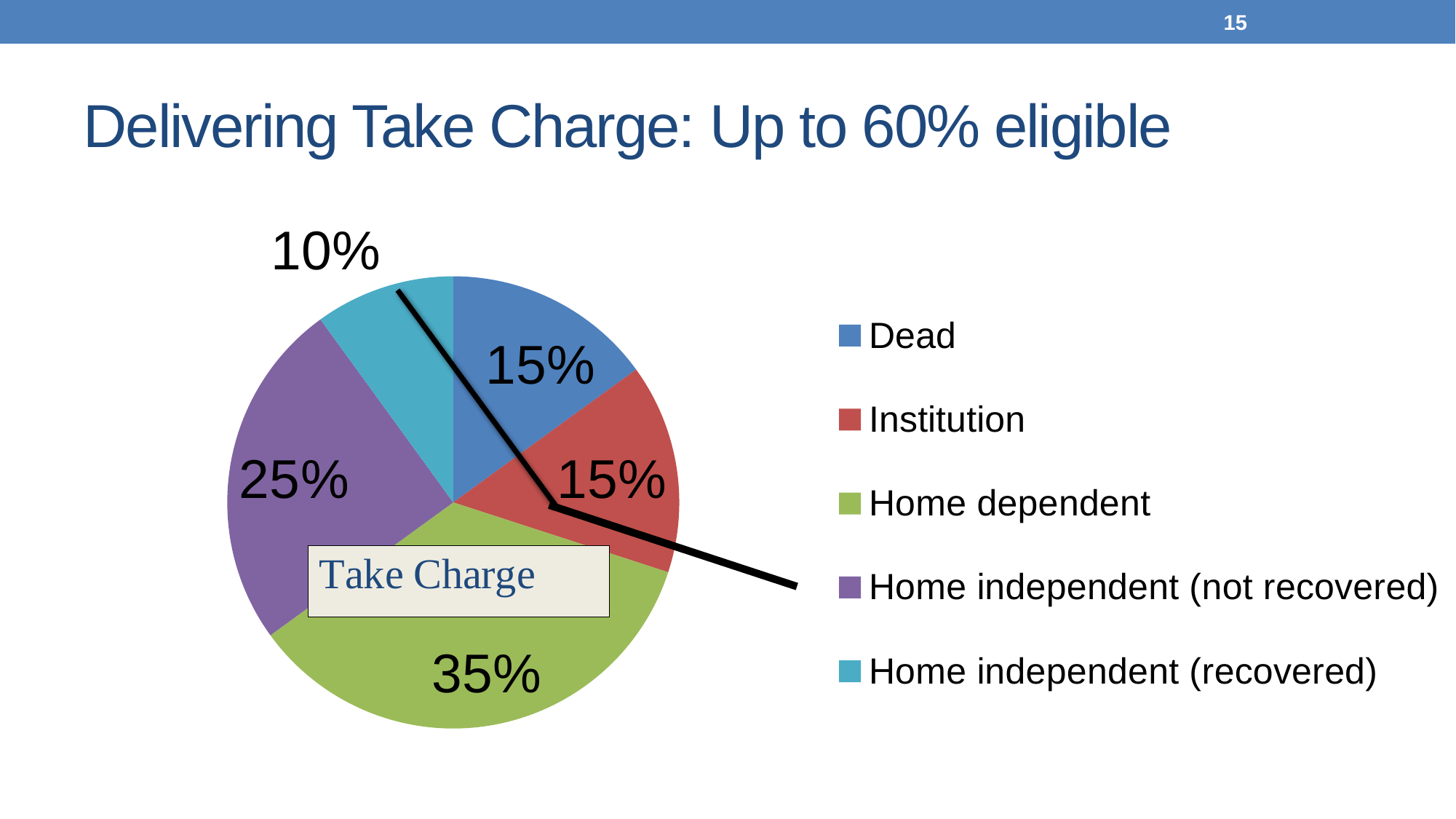
What percentage of the pie is labelled Home independent (recovered)? 10% Which is larger, the Home independent (not recovered) slice or the Dead slice? Home independent (not recovered) What percentage of the pie is labelled Dead? 15% What percentage of the pie is labelled Institution? 15% Which category has the smallest slice of the pie? Home independent (recovered) What colour is the Home dependent slice? Green Which category has the largest slice of the pie? Home dependent What is the difference between the Home dependent share and the Home independent (not recovered) share? 10% What kind of chart is shown on the slide? Pie chart What percentage of the pie is labelled Home dependent? 35% What percentage of the pie is labelled Home independent (not recovered)? 25% How many categories does the legend list? 5